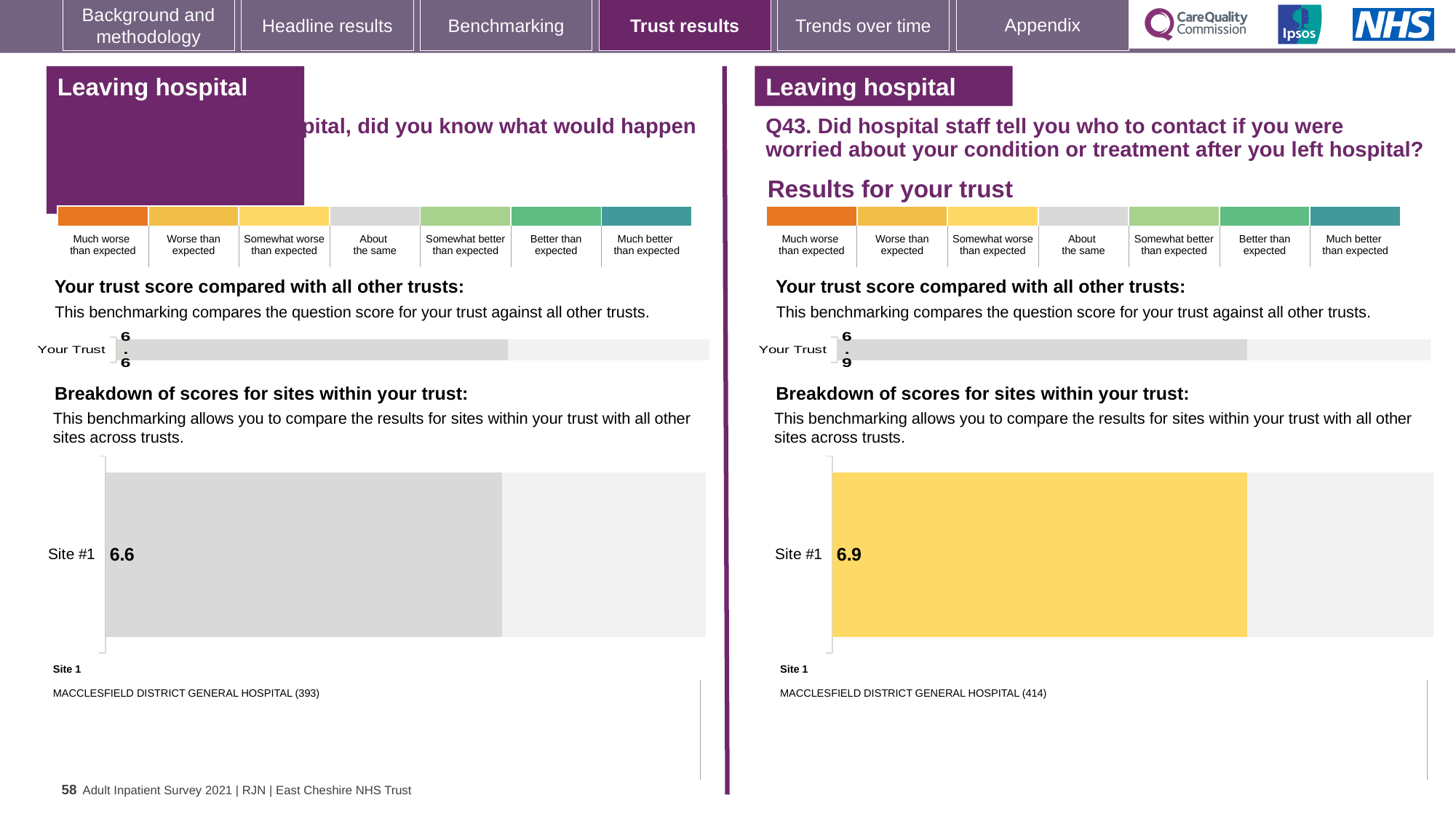
What is the difference between the Site #1 score in the right-hand Q43 chart and the Site #1 score in the left-hand chart? 0.3 Which hospital is listed as Site 1 below the right-hand Q43 site breakdown chart? MACCLESFIELD DISTRICT GENERAL HOSPITAL (414) In the site breakdown chart for Q43 on the right, what is the score for Site #1? 6.9 On the right-hand chart for Q43, what is the score shown for Your Trust? 6.9 What colour is the Site #1 bar in the right-hand Q43 site breakdown chart? Yellow How many sites are shown in the site breakdown chart on the left-hand side of the slide? 1 Which is larger: the Site #1 score in the left-hand chart or the Site #1 score in the right-hand Q43 chart? Right-hand Q43 chart What type of chart is used to show the Site #1 score on the right-hand side of the slide? Bar chart In the site breakdown chart on the left-hand side of the slide, what is the score for Site #1? 6.6 How many sites are shown in the site breakdown chart for Q43 on the right? 1 On the left-hand side of the slide, what is the score shown for Your Trust? 6.6